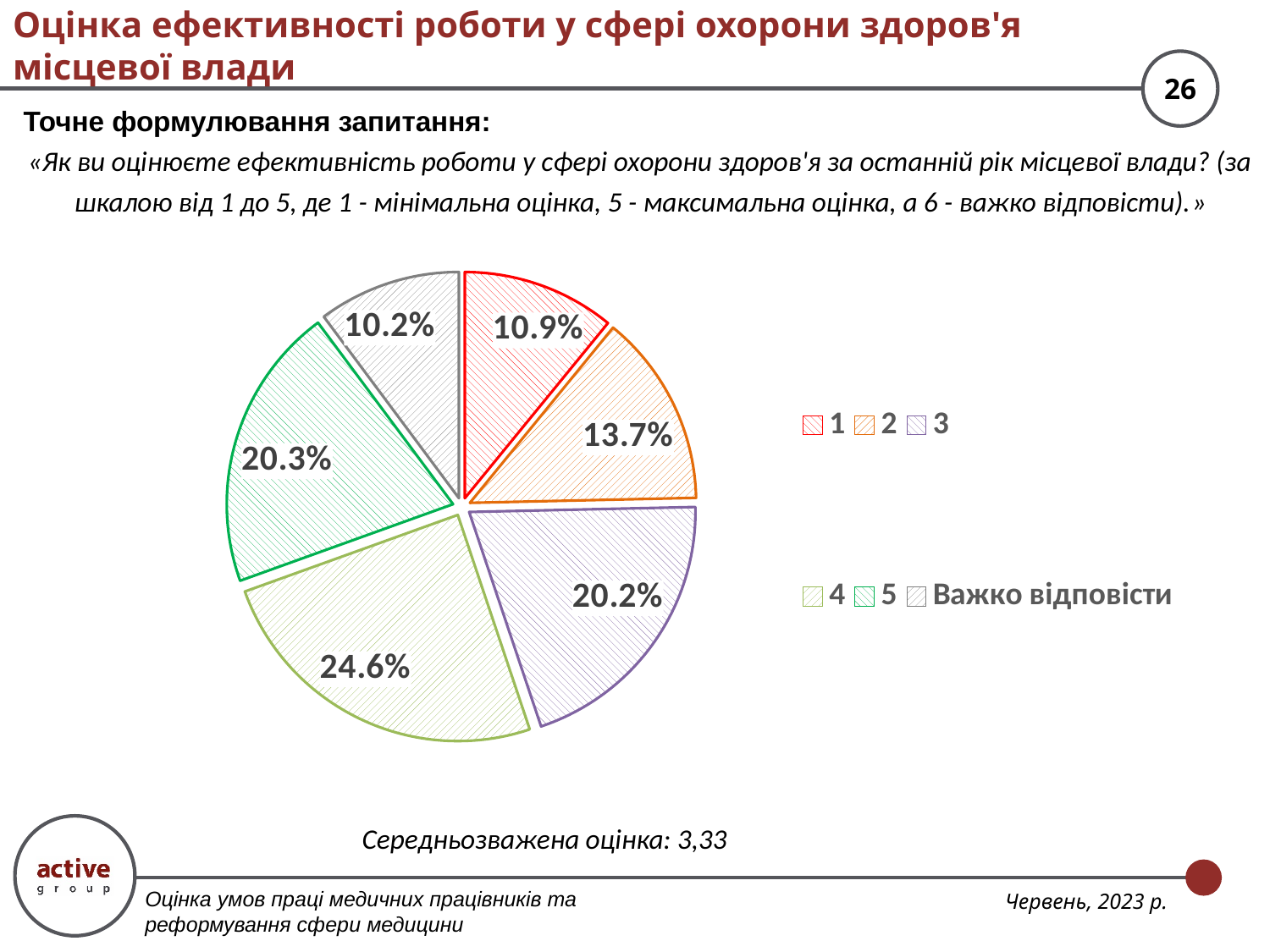
Which rating category has the largest slice of the pie? 4 Which is larger: the share for rating 2 or the share for rating 5? 5 How many slices does the pie chart have? 6 How many entries does the legend list? 6 Which category has the smallest slice of the pie? Важко відповісти What share of respondents gave a rating of 1? 10.9% What share of respondents gave a rating of 4? 24.6% What share of respondents gave a rating of 2? 13.7% What is the combined share of respondents who gave a rating of 1 or 2? 24.6% What is the difference in percentage points between the share for rating 4 and the share for rating 1? 13.7 What kind of chart is shown on the slide? pie chart What share of respondents answered "Важко відповісти"? 10.2%